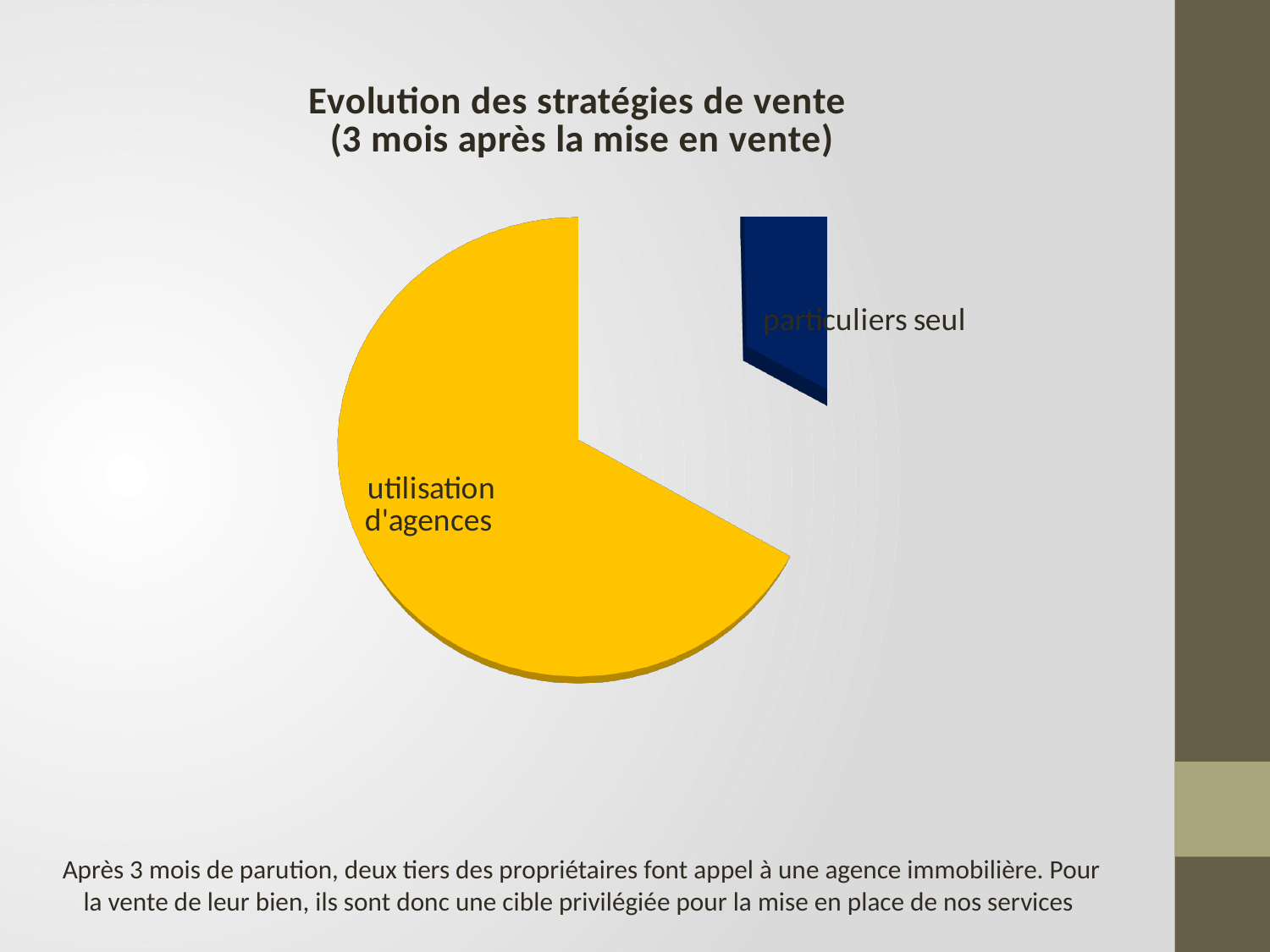
What is the title of the chart? Evolution des stratégies de vente (3 mois après la mise en vente) What colour is the "particuliers seul" slice? Dark blue How many slices does the pie chart have? 2 Which category has the largest slice of the pie chart? utilisation d'agences Which category has the smallest slice of the pie chart? particuliers seul What kind of chart is shown on the slide? Pie chart Which slice is larger: "utilisation d'agences" or "particuliers seul"? utilisation d'agences